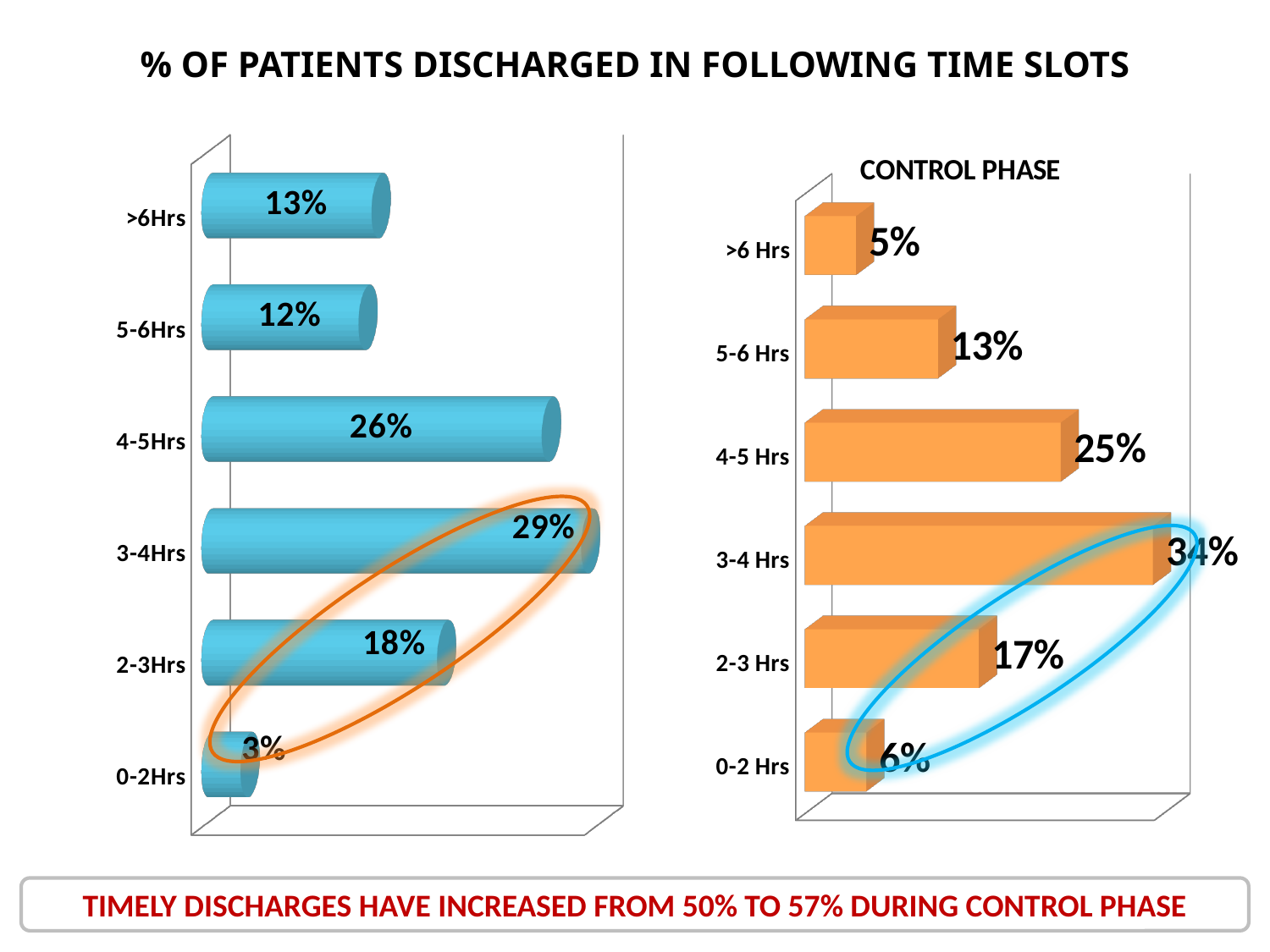
In the Control Phase chart, which time slot has the lowest percentage? >6 Hrs In the Control Phase chart, what is the difference between the 4-5 Hrs and 2-3 Hrs values? 8% What is the title of the right-hand chart? CONTROL PHASE In the Control Phase chart, what is the value for >6 Hrs? 5% In the left (blue) chart, what percentage of patients were discharged in the 4-5Hrs slot? 26% How many time slot categories does each chart show? 6 In the Control Phase chart, what percentage of patients were discharged in the 3-4 Hrs slot? 34% In the left (blue) chart, which time slot has the highest percentage? 3-4Hrs Which is larger: the 0-2 Hrs value in the Control Phase chart or the 0-2Hrs value in the left chart? Control Phase chart (6%) What type of chart is used on this slide? Bar chart What is the difference between the 3-4 Hrs value in the Control Phase chart and the 3-4Hrs value in the left chart? 5% In the left (blue) chart, which time slot has the lowest percentage? 0-2Hrs